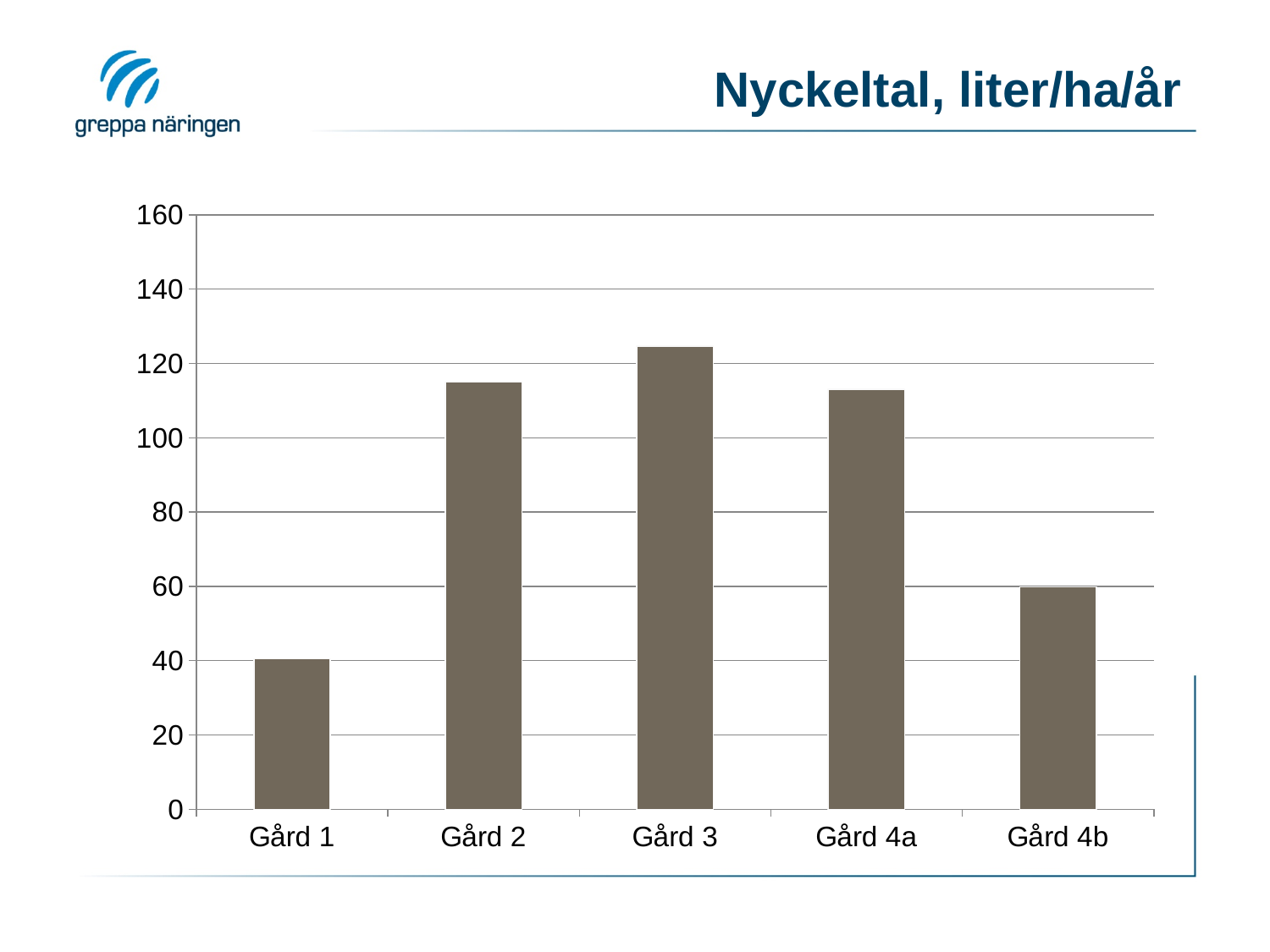
Is the value for Gård 4b greater or less than 80? less Is the value for Gård 3 greater or less than 120? greater Which is larger, the value for Gård 3 or the value for Gård 4a? Gård 3 Which is larger, the value for Gård 2 or the value for Gård 4b? Gård 2 What kind of chart is shown on the slide? bar chart What is the title of the chart? Nyckeltal, liter/ha/år How many categories (gårdar) are shown on the x axis? 5 Which gård has the lowest value? Gård 1 Which gård has the highest value? Gård 3 Is the value for Gård 2 greater or less than 100? greater